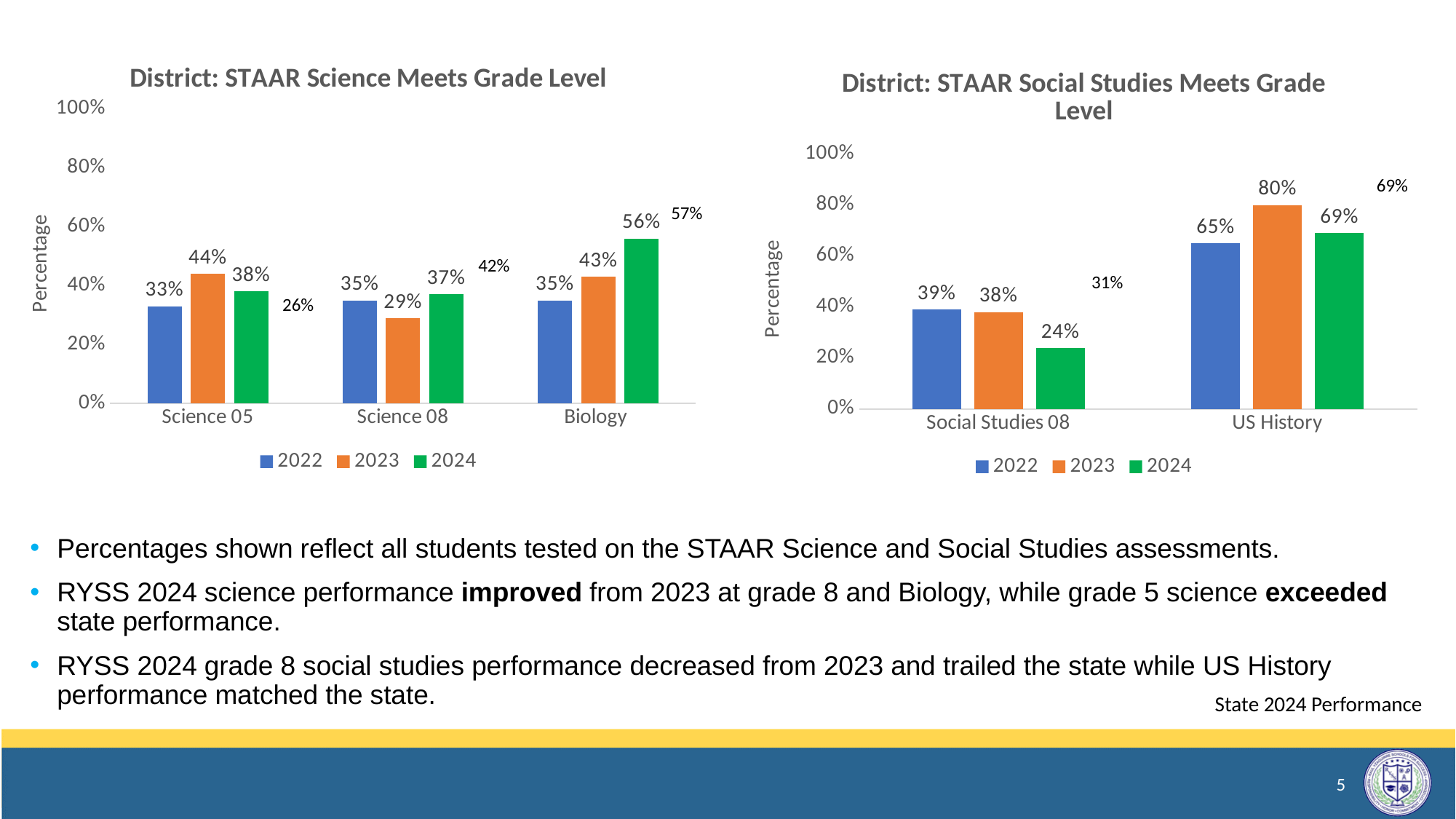
In the 'District: STAAR Social Studies Meets Grade Level' chart, what is the 2024 value for Social Studies 08? 24% In the 'District: STAAR Science Meets Grade Level' chart, how many categories are shown on the x axis? 3 In the 'District: STAAR Science Meets Grade Level' chart, is the 2022 value for Science 05 greater or less than 40%? less In the 'District: STAAR Social Studies Meets Grade Level' chart, how many series does the legend list? 3 In the 'District: STAAR Social Studies Meets Grade Level' chart, what is the difference between the 2022 and 2024 values for Social Studies 08? 15% In the 'District: STAAR Science Meets Grade Level' chart, which year has the lowest value for Science 08? 2023 In the 'District: STAAR Science Meets Grade Level' chart, what is the 2023 value for Science 05? 44% What type of chart is the 'District: STAAR Social Studies Meets Grade Level' chart? Bar chart In the 'District: STAAR Social Studies Meets Grade Level' chart, which year has the highest value for US History? 2023 In the 'District: STAAR Social Studies Meets Grade Level' chart, what is the 2023 value for US History? 80% In the 'District: STAAR Science Meets Grade Level' chart, what is the 2024 value for Biology? 56% In the 'District: STAAR Science Meets Grade Level' chart, what is the difference between the 2024 and 2023 values for Biology? 13%